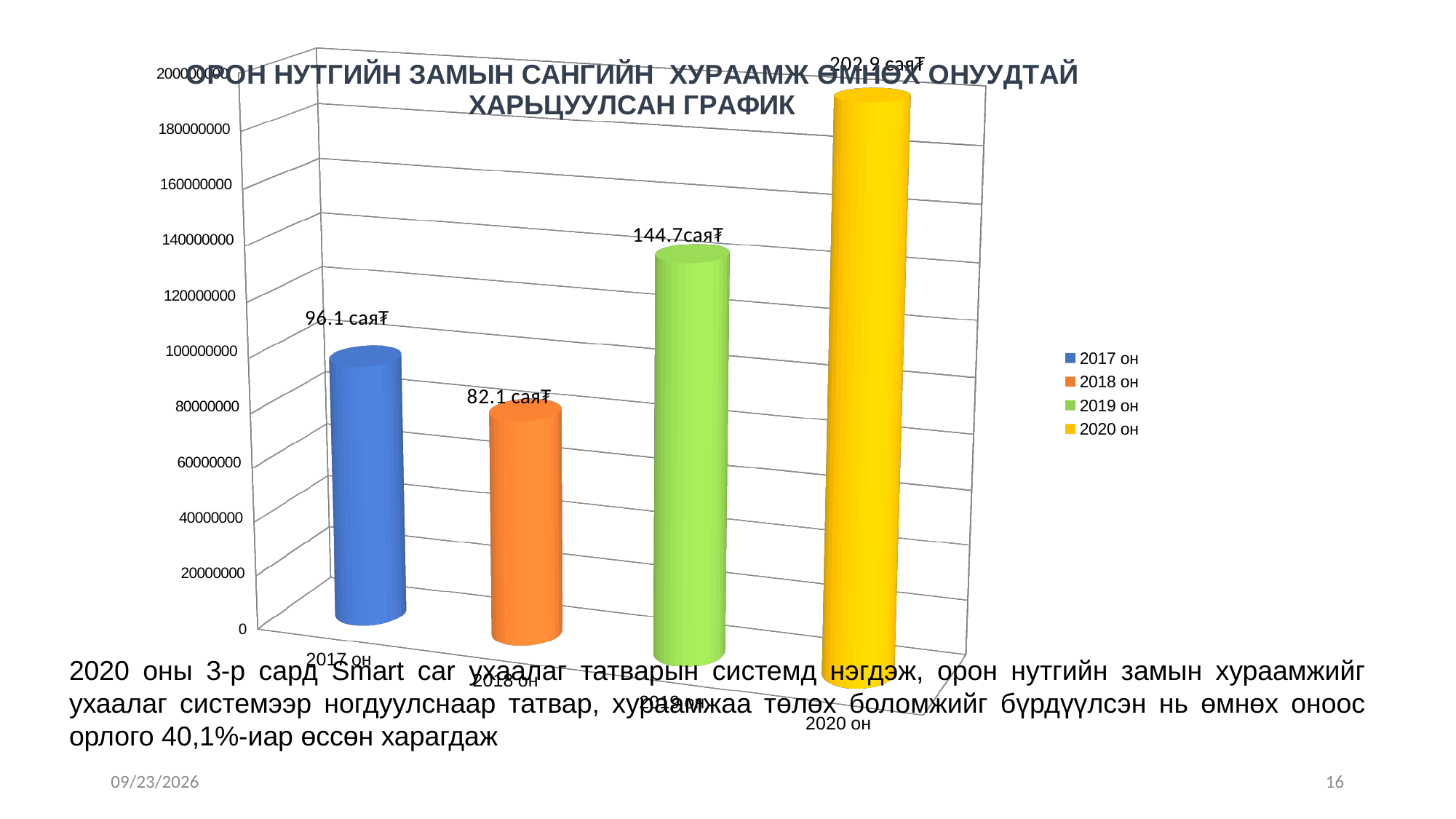
What is the value shown for 2020 он? 202.9 сая₮ What is the difference between the values for 2020 он and 2019 он? 58.2 сая₮ Which year has the highest value? 2020 он What kind of chart is shown on the slide? bar chart What is the value shown for 2019 он? 144.7сая₮ What is the value shown for 2018 он? 82.1 сая₮ What is the value shown for 2017 он? 96.1 сая₮ Which is larger, the value for 2017 он or the value for 2018 он? 2017 он Is the value for 2020 он greater or less than 180000000? greater Which year has the lowest value? 2018 он How many entries does the legend list? 4 How many bars are plotted in the chart? 4